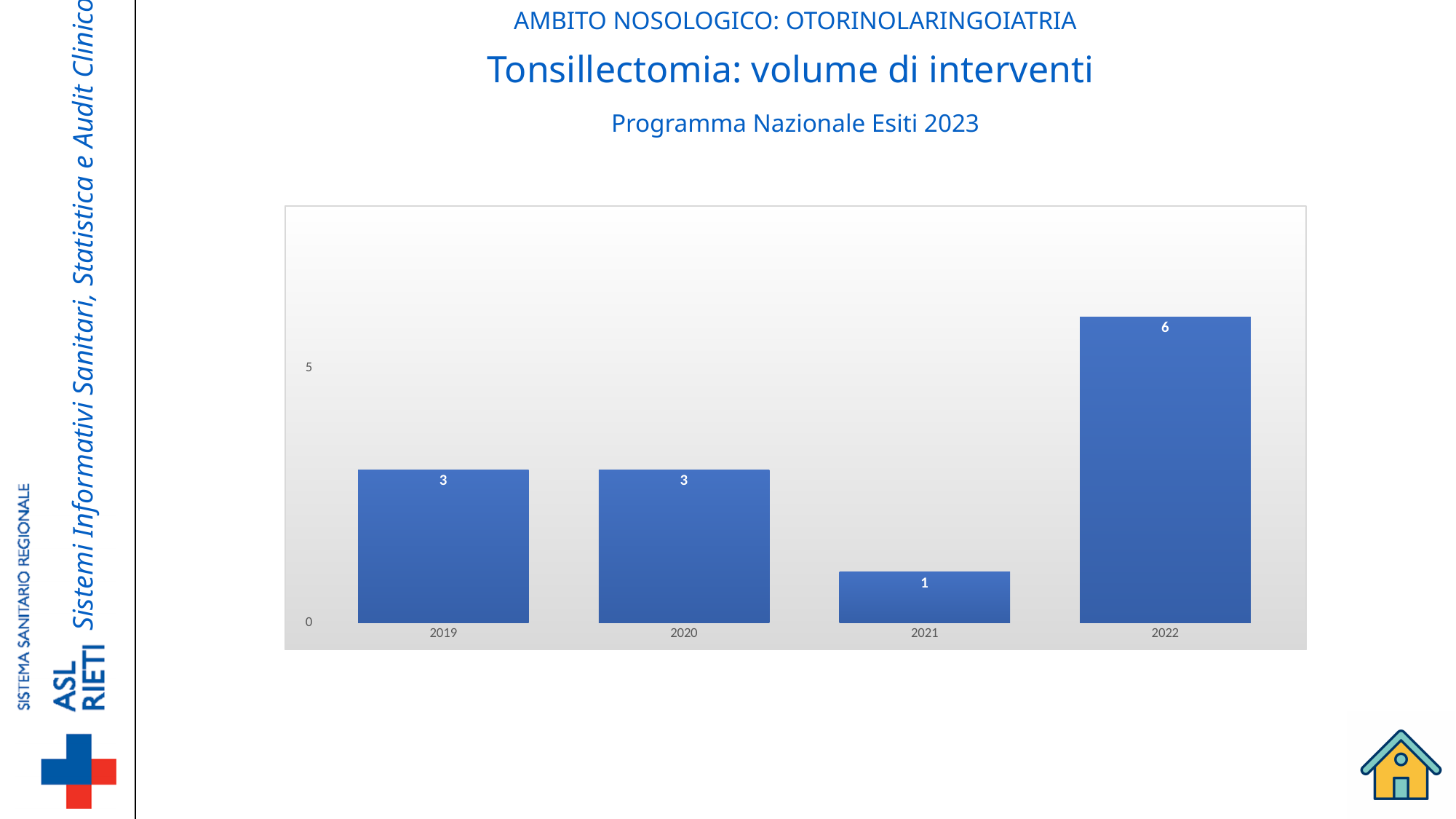
Which year has the highest value? 2022 Do the values rise or fall from 2021 to 2022? rise How many years are shown on the x axis? 4 What is the value for 2022? 6 Which year has the lowest value? 2021 What is the value for 2021? 1 What is the value for 2019? 3 Which is larger, the value for 2020 or the value for 2021? 2020 What is the difference between the values for 2022 and 2021? 5 What is the title of the slide above the chart? Tonsillectomia: volume di interventi Is the value for 2022 greater or less than 5? greater What kind of chart is shown on the slide? bar chart